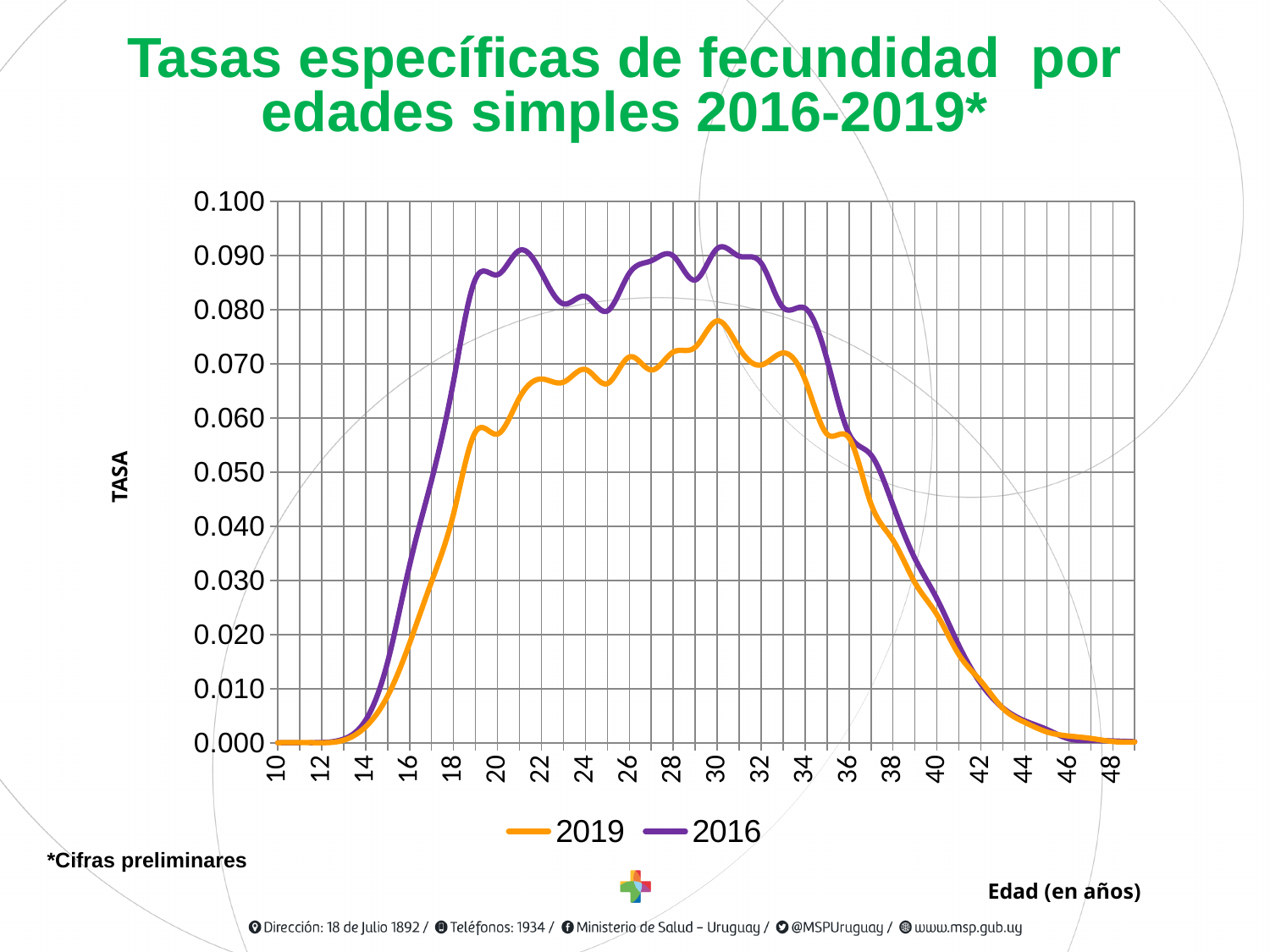
Which two years are shown in the legend? 2019 and 2016 Do the values for 2019 rise or fall between age 36 and age 48? fall Is the value for 2019 at age 30 greater or less than 0.070? greater What kind of chart is shown on the slide? Line chart Is the value for 2019 at age 16 greater or less than 0.030? less Is the value for 2016 at age 36 greater or less than 0.050? greater At age 25, which series has the higher value, 2019 or 2016? 2016 How many series does the legend list? 2 What is the label of the vertical axis? TASA Which series reaches the higher peak value, 2019 or 2016? 2016